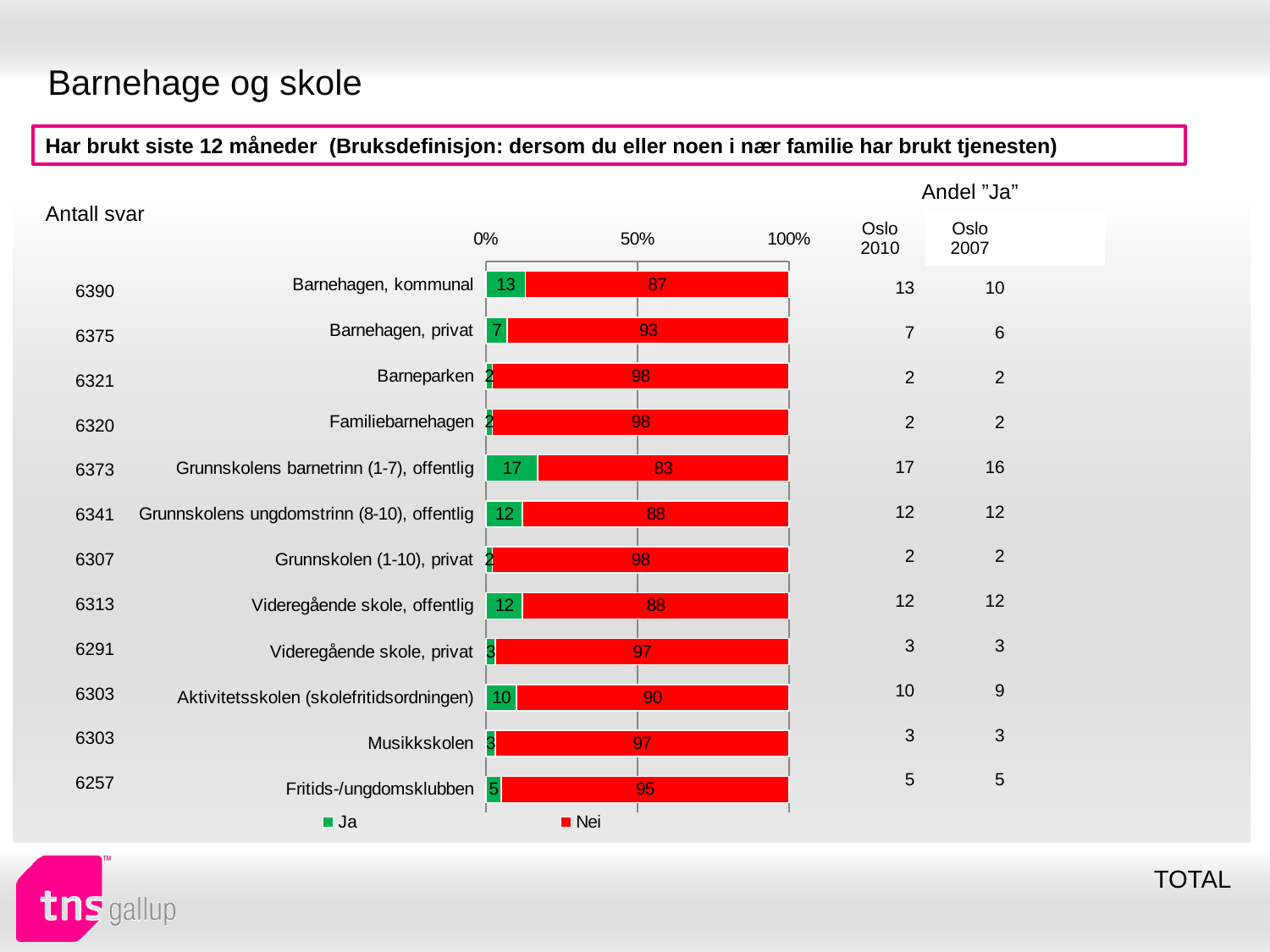
What is the "Nei" value for Grunnskolens barnetrinn (1-7), offentlig? 83 What is the "Ja" value for Barnehagen, kommunal? 13 How many series does the legend list? 2 Which category has the lowest "Nei" value? Grunnskolens barnetrinn (1-7), offentlig What is the difference between the "Ja" values for Barnehagen, kommunal and Barnehagen, privat? 6 What kind of chart is shown on the slide? Stacked bar chart Which category has the highest "Ja" value? Grunnskolens barnetrinn (1-7), offentlig What is the "Nei" value for Fritids-/ungdomsklubben? 95 What is the total of the stacked bar for Barnehagen, kommunal? 100 Is the "Nei" value for Barneparken greater or less than 50%? greater Which has the larger "Ja" value: Aktivitetsskolen (skolefritidsordningen) or Videregående skole, offentlig? Videregående skole, offentlig How many categories are shown in the chart? 12